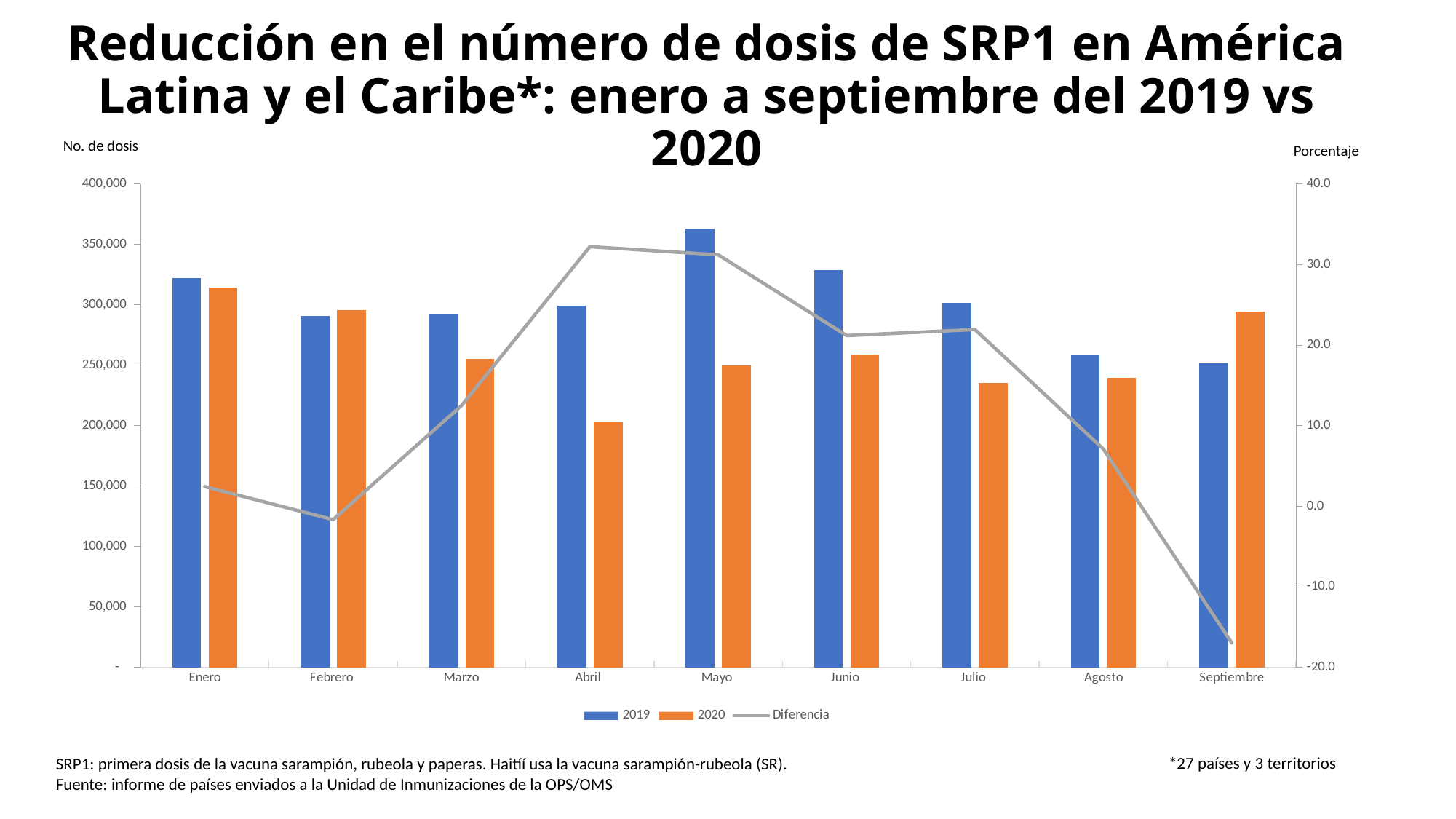
Is the Diferencia value for Septiembre greater or less than -10.0? less Does the Diferencia line rise or fall from Julio to Septiembre? Fall Is the 2019 value for Mayo greater or less than 350,000? greater In Septiembre, which is larger: the 2019 bar or the 2020 bar? 2020 Which month has the lowest number of doses for 2020? Abril How many months are shown on the x axis? 9 How many series does the legend list? 3 Which month has the highest number of doses for 2020? Enero Which month has the lowest value on the Diferencia line? Septiembre Is the 2020 value for Abril greater or less than 250,000? less What kind of chart is shown on the slide? A bar chart combined with a line Which month has the highest number of doses for 2019? Mayo